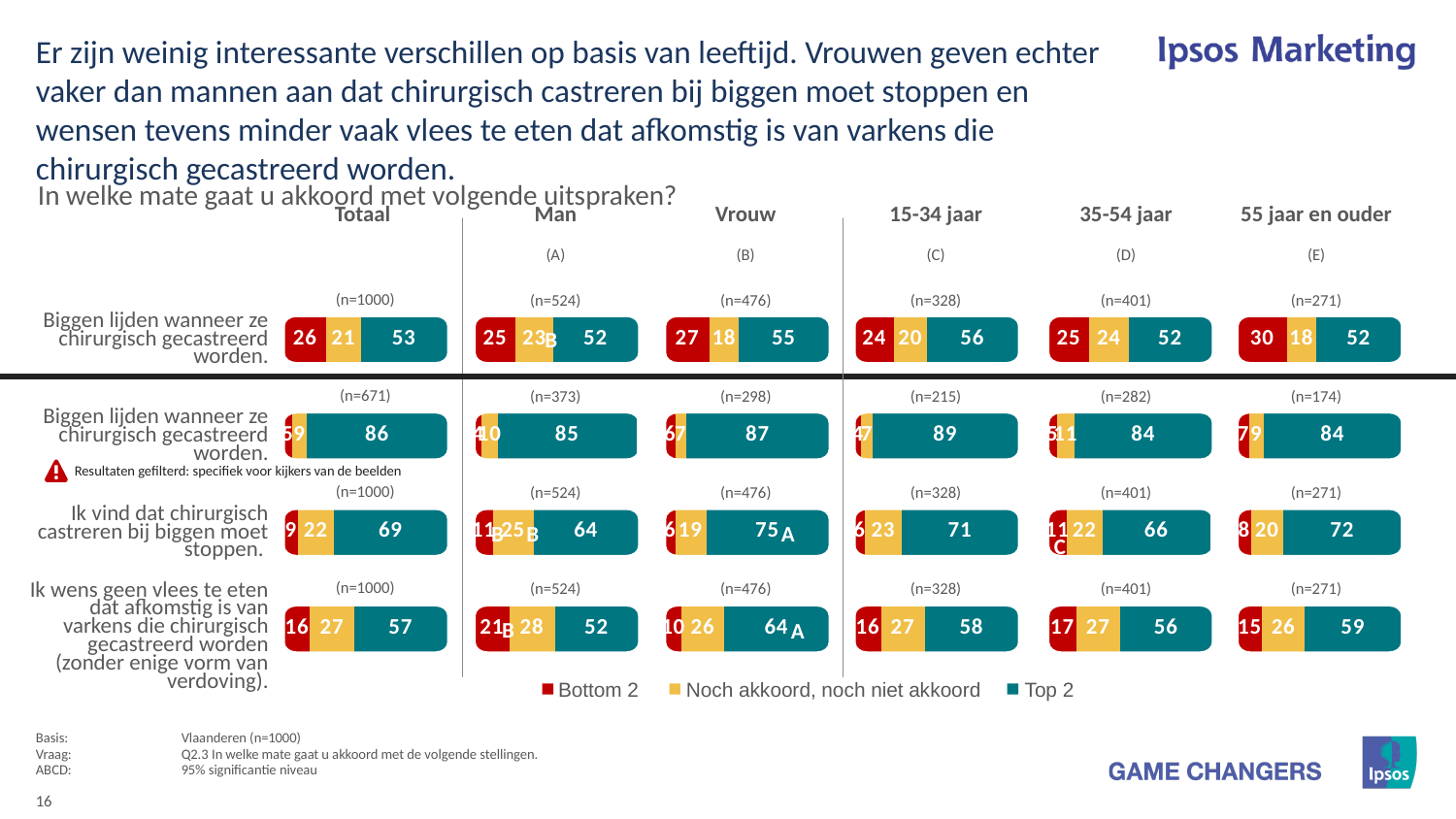
For the filtered statement 'Biggen lijden wanneer ze chirurgisch gecastreerd worden' (n=671), what is the Top 2 value for 15-34 jaar? 89 For the statement 'Ik vind dat chirurgisch castreren bij biggen moet stoppen', which group has the highest Top 2 value? Vrouw For the statement 'Ik wens geen vlees te eten dat afkomstig is van varkens die chirurgisch gecastreerd worden', which is larger: the Top 2 value for Vrouw or for Man? Vrouw For the statement 'Ik wens geen vlees te eten dat afkomstig is van varkens die chirurgisch gecastreerd worden', which group has the lowest Top 2 value? Man How many series does the legend list? 3 For the statement 'Biggen lijden wanneer ze chirurgisch gecastreerd worden' (n=1000), what is the total of the Totaal bar (Bottom 2 + Noch akkoord + Top 2)? 100 For the statement 'Biggen lijden wanneer ze chirurgisch gecastreerd worden' (n=1000), what is the Top 2 value for Totaal? 53 For the statement 'Ik vind dat chirurgisch castreren bij biggen moet stoppen', what is the Top 2 value for Vrouw? 75 For the statement 'Ik vind dat chirurgisch castreren bij biggen moet stoppen', what is the difference between the Top 2 values for Vrouw and Man? 11 For the statement 'Ik wens geen vlees te eten dat afkomstig is van varkens die chirurgisch gecastreerd worden', what is the Bottom 2 value for Man? 21 How many respondent groups (columns) are shown across the slide? 6 What kind of chart is used on this slide? Stacked bar chart